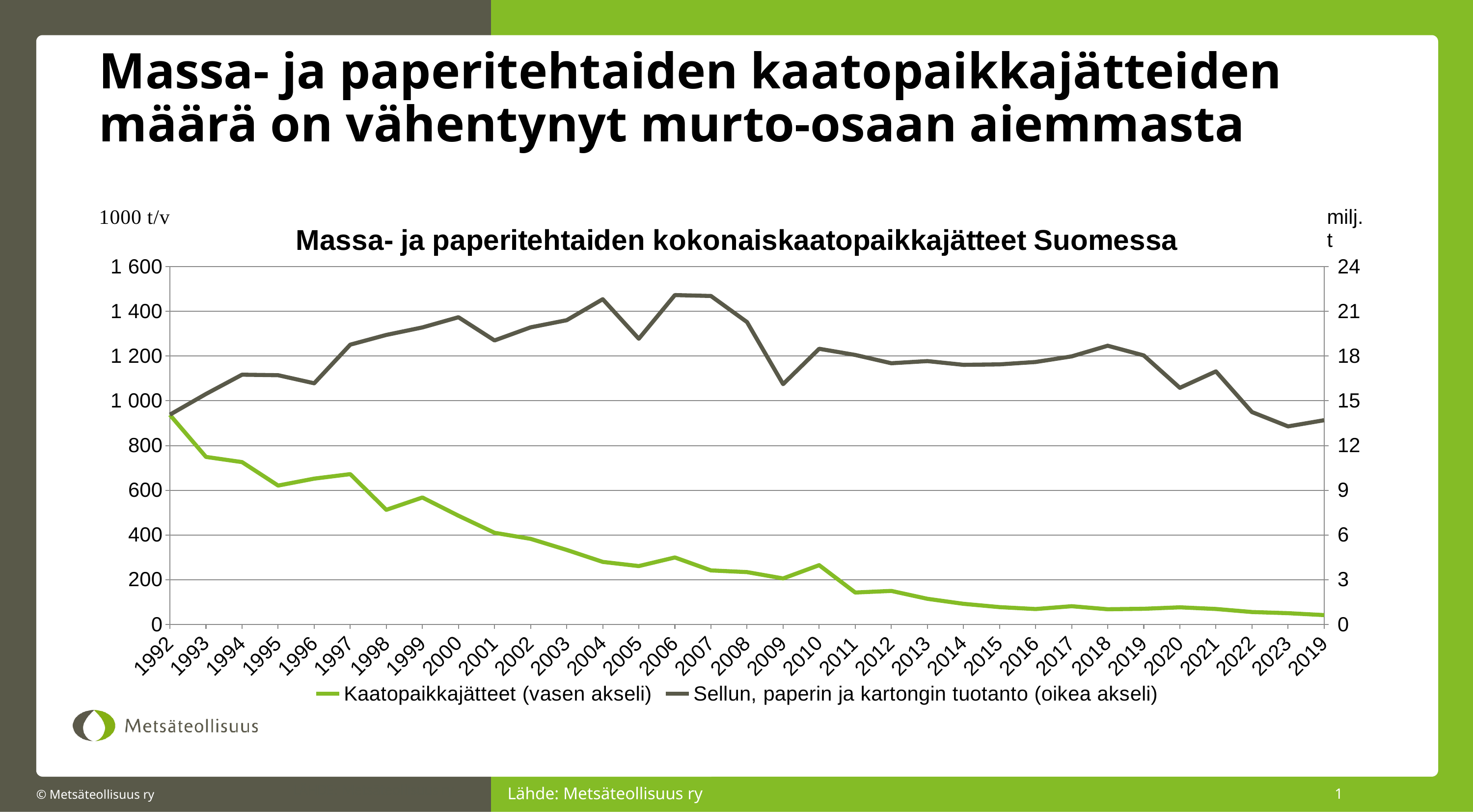
Is the Sellun, paperin ja kartongin tuotanto value for 2009 greater or less than 18? less In which year is the Kaatopaikkajätteet series at its highest? 1992 Which series is drawn in green? Kaatopaikkajätteet (vasen akseli) Do the values of the Kaatopaikkajätteet series rise or fall from 1992 to 2023? fall What is the title of the chart? Massa- ja paperitehtaiden kokonaiskaatopaikkajätteet Suomessa Is the Kaatopaikkajätteet value for 1992 greater or less than 800? greater Is the Kaatopaikkajätteet value for 2000 greater or less than 400? greater What kind of chart is shown on the slide? line chart Which is larger for the Kaatopaikkajätteet series, the value for 1992 or the value for 2023? 1992 How many series does the legend list? 2